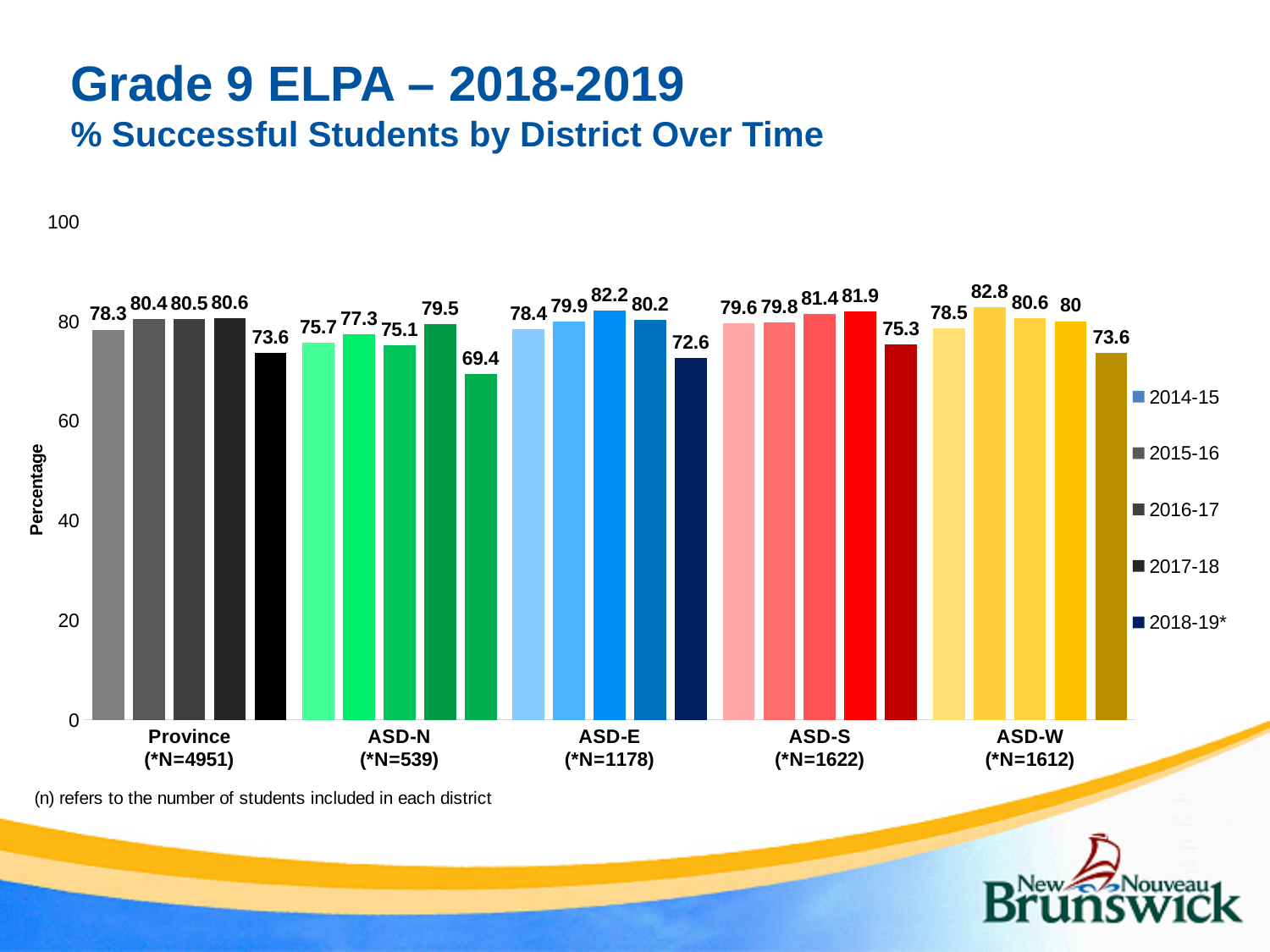
Which is larger, the ASD-E value for 2014-15 or the ASD-S value for 2014-15? ASD-S How many series does the legend list? 5 What is the label of the y axis? Percentage Which district has the lowest value in 2018-19*? ASD-N What is the value for ASD-N in 2018-19*? 69.4 What is the value for the Province in 2017-18? 80.6 What is the difference between the ASD-S values for 2017-18 and 2018-19*? 6.6 What kind of chart is shown on the slide? bar chart Which district has the highest value in 2016-17? ASD-E Is the value for ASD-N in 2018-19* greater or less than 80? less What is the value for ASD-W in 2015-16? 82.8 How many districts (category groups) are shown on the x axis? 5